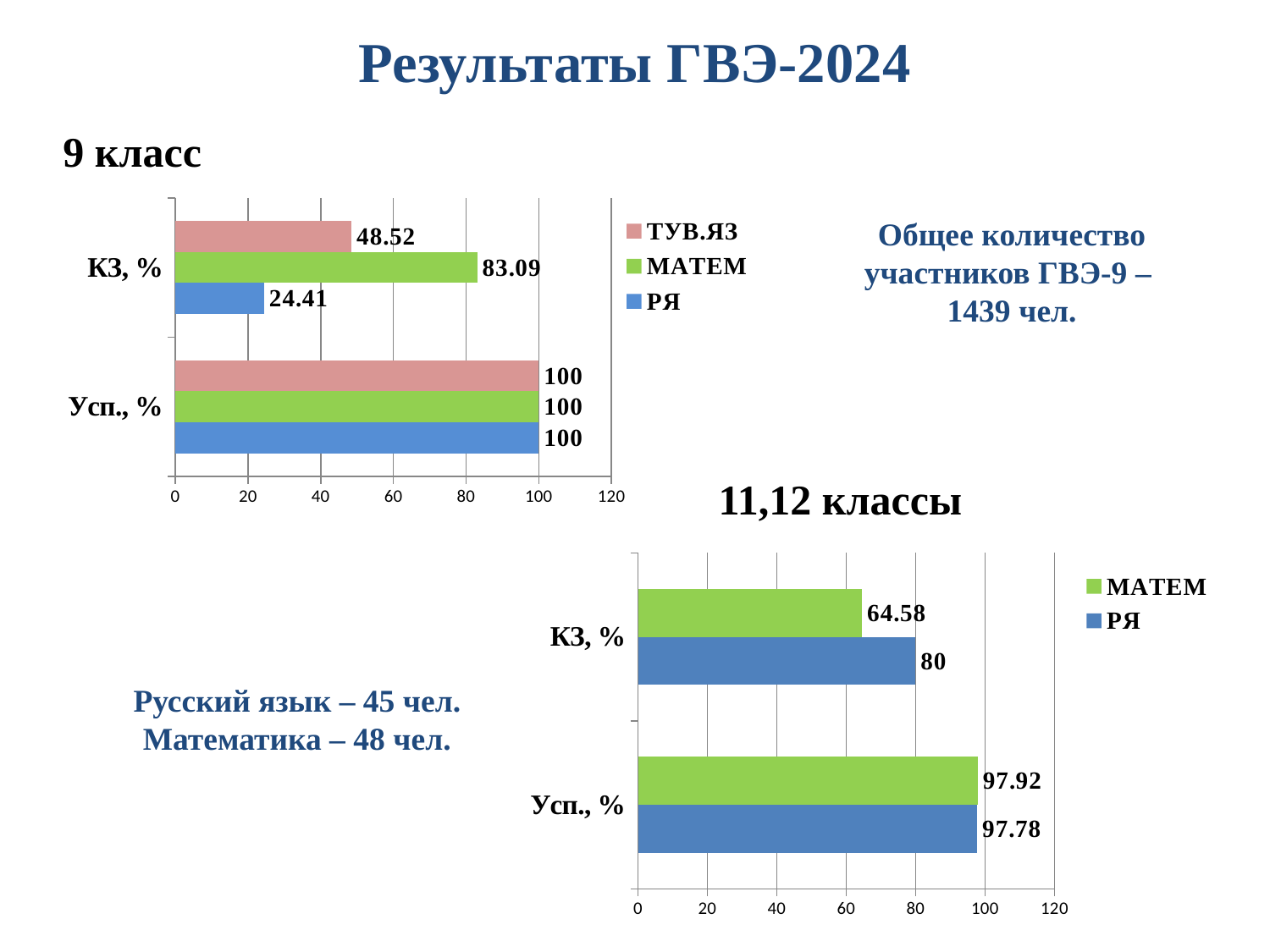
In the '9 класс' chart, what is the difference between the МАТЕМ and ТУВ.ЯЗ values for КЗ, %? 34.57 How many series does the legend of the '11,12 классы' chart list? 2 In the '9 класс' chart, what is the value of ТУВ.ЯЗ for Усп., %? 100 How many series does the legend of the '9 класс' chart list? 3 In the '9 класс' chart, which series has the lowest value for КЗ, %? РЯ In the '11,12 классы' chart, what is the difference between the РЯ and МАТЕМ values for КЗ, %? 15.42 In the '9 класс' chart, what is the value of РЯ for КЗ, %? 24.41 In the '9 класс' chart, what is the value of МАТЕМ for КЗ, %? 83.09 What type of chart is the '9 класс' chart? Bar chart In the '11,12 классы' chart, what is the value of МАТЕМ for Усп., %? 97.92 In the '11,12 классы' chart, what is the value of РЯ for КЗ, %? 80 In the '11,12 классы' chart, which series has the larger value for КЗ, %: МАТЕМ or РЯ? РЯ